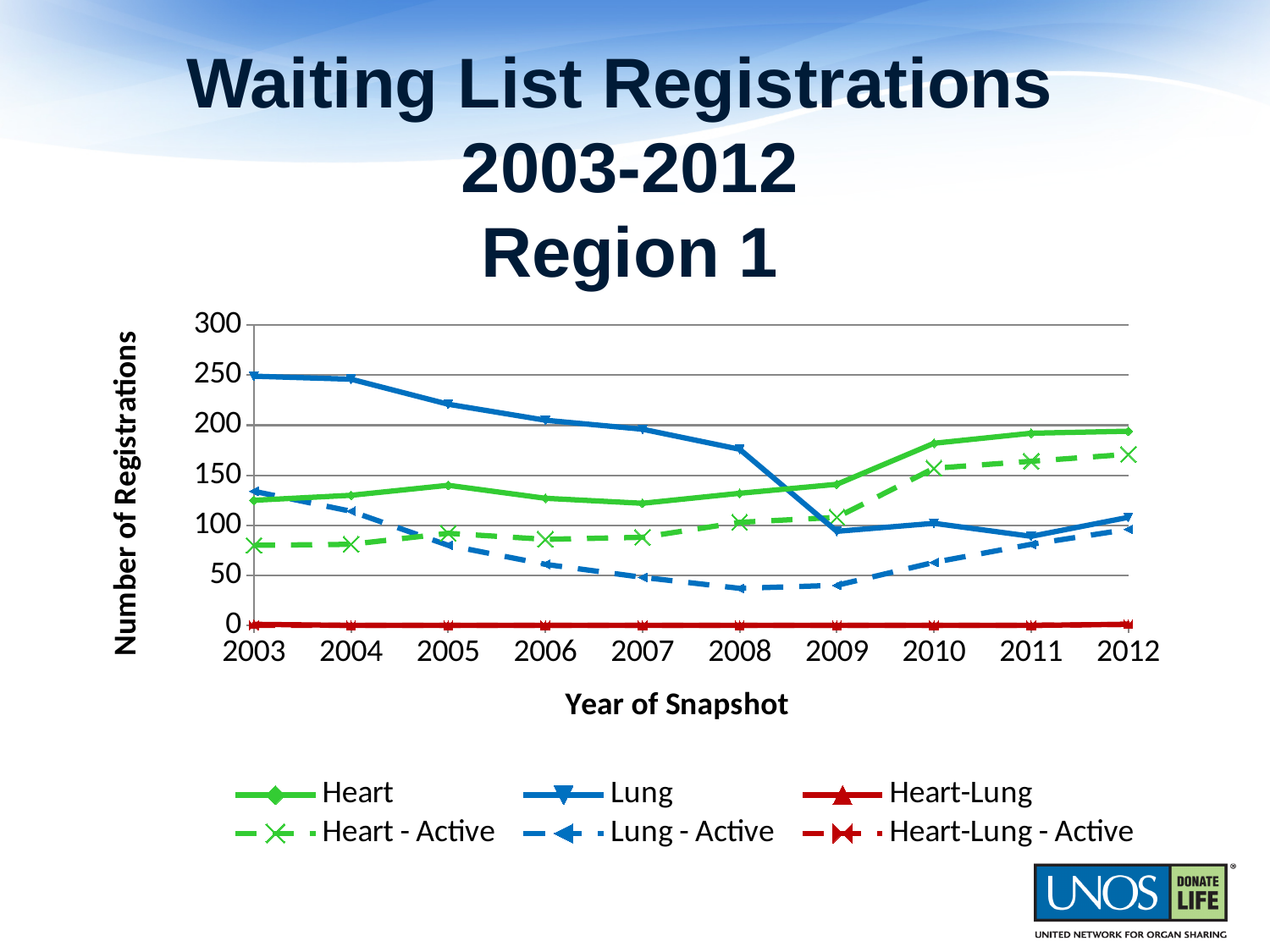
Is the value for Heart - Active in 2003 greater or less than 100? less How many series does the legend list? 6 What kind of chart is shown on the slide? line chart Is the value for Lung - Active in 2008 greater or less than 50? less Is the value for Heart in 2010 greater or less than 150? greater Which series has the larger value in 2012, Heart or Lung? Heart Does the Lung series rise or fall from 2003 to 2009? fall Does the Heart - Active series rise or fall from 2009 to 2012? rise How many years are plotted along the x axis? 10 Which series has the larger value in 2003, Heart or Lung? Lung What is the label of the y axis? Number of Registrations